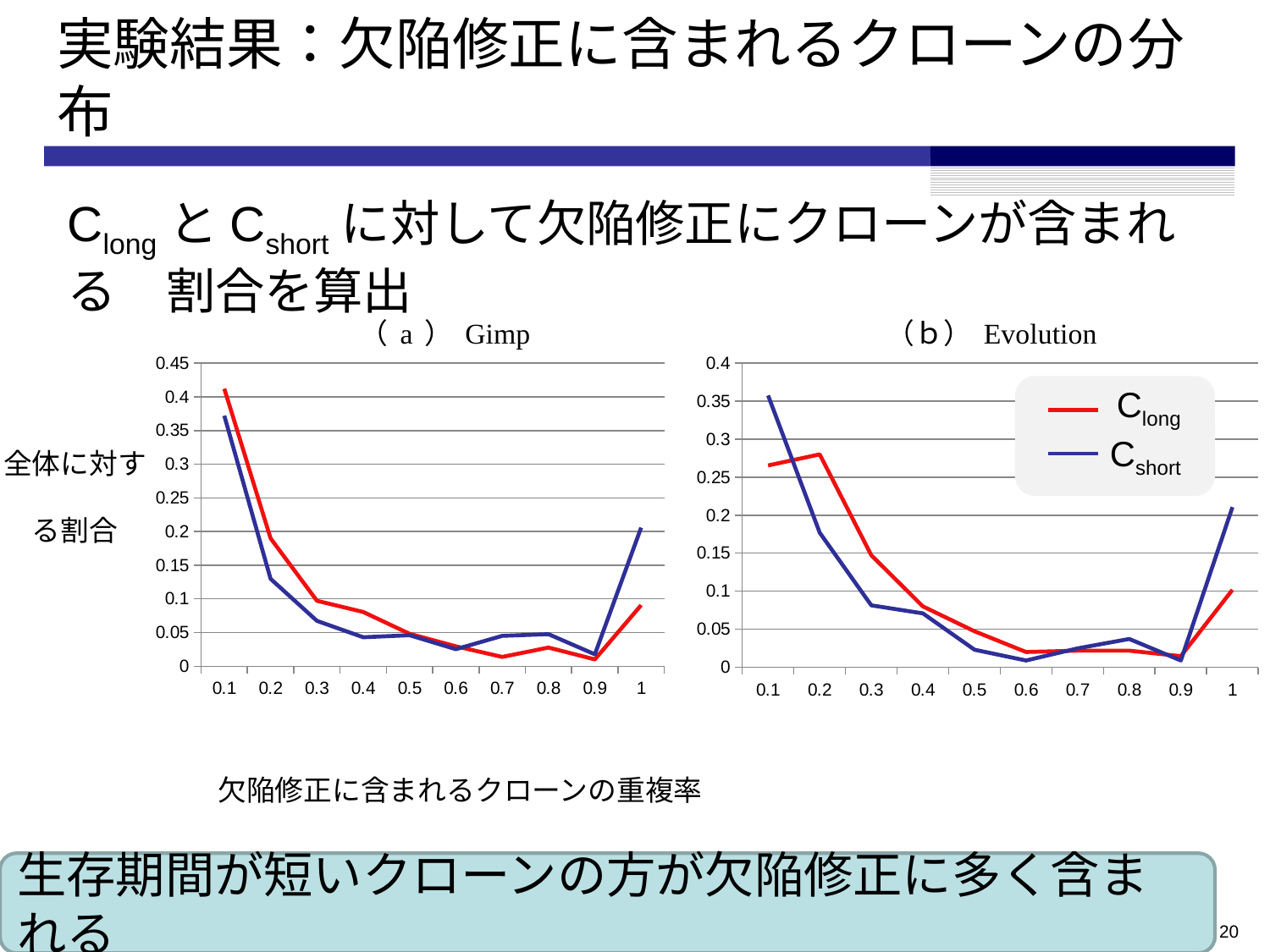
On the (a) Gimp chart, is the value of C_long at 0.1 greater or less than 0.4? greater What kind of chart is the (a) Gimp chart? line chart On the (b) Evolution chart, which series has the larger value at 0.2: C_long or C_short? C_long On the (b) Evolution chart, is the value of C_long at 0.1 greater or less than 0.3? less On the (a) Gimp chart, which series has the larger value at 0.2: C_long or C_short? C_long On the (b) Evolution chart, do the C_short values rise or fall from 0.1 to 0.5 along the x axis? fall How many x-axis points are plotted on the (a) Gimp chart? 10 On the (a) Gimp chart, is the value of C_short at 0.1 greater or less than 0.4? less On the (b) Evolution chart, what colour is the C_long line? red How many series does the legend on the (b) Evolution chart list? 2 On the (a) Gimp chart, which series has the larger value at 1: C_long or C_short? C_short